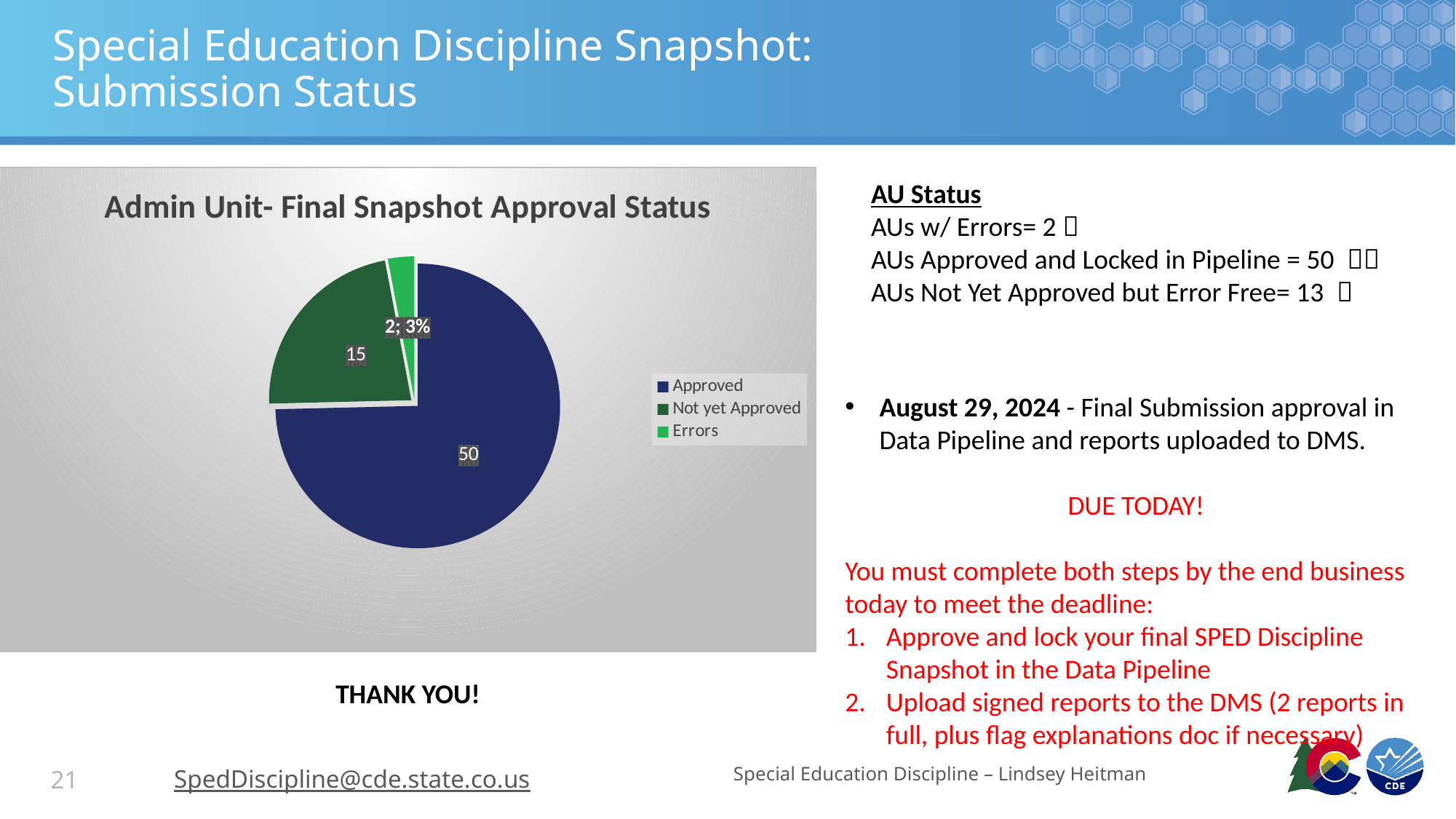
What kind of chart is shown on the slide? pie chart What percentage share of the pie does the Errors slice represent? 3% Which category has the largest slice of the pie? Approved What is the value for the Errors slice? 2 Which category has the smallest slice of the pie? Errors How many categories does the pie chart have? 3 What is the value for the Not yet Approved slice? 15 What is the total of all the slice values in the pie chart? 67 What is the value for the Approved slice? 50 What is the difference between the Approved value and the Not yet Approved value? 35 What is the title of the chart? Admin Unit- Final Snapshot Approval Status Which is larger, the Not yet Approved slice or the Errors slice? Not yet Approved